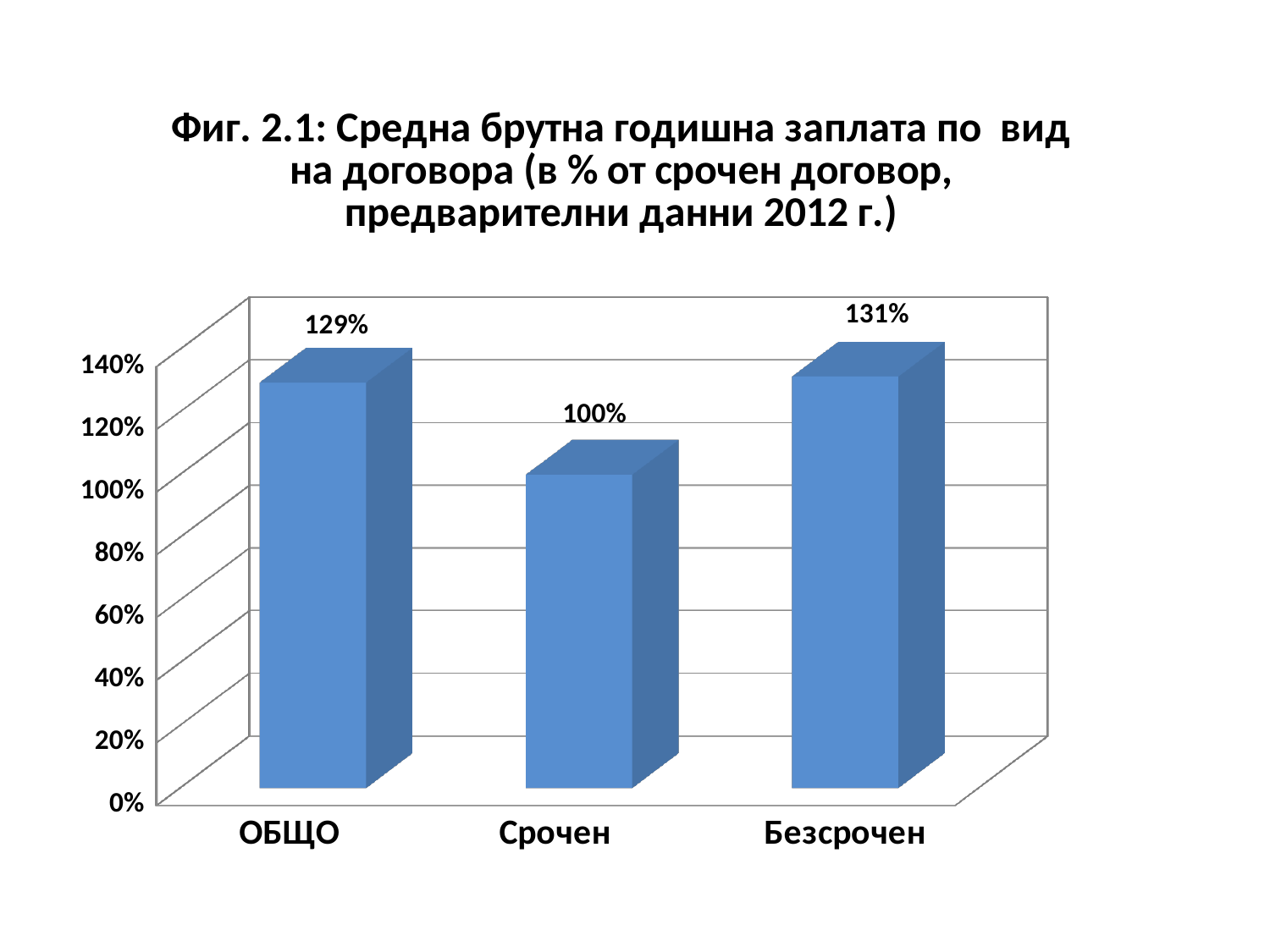
What is the figure number given in the chart title? Фиг. 2.1 Is the value for Безсрочен greater or less than 120%? greater How many categories are shown on the x axis? 3 What kind of chart is shown on the slide? bar chart What is the value for ОБЩО? 129% What is the difference between the values for ОБЩО and Срочен? 29% What is the value for Безсрочен? 131% Which category has the lowest value? Срочен What is the difference between the values for Безсрочен and Срочен? 31% What is the value for Срочен? 100% Which category has the highest value? Безсрочен Which is larger, the value for ОБЩО or the value for Срочен? ОБЩО